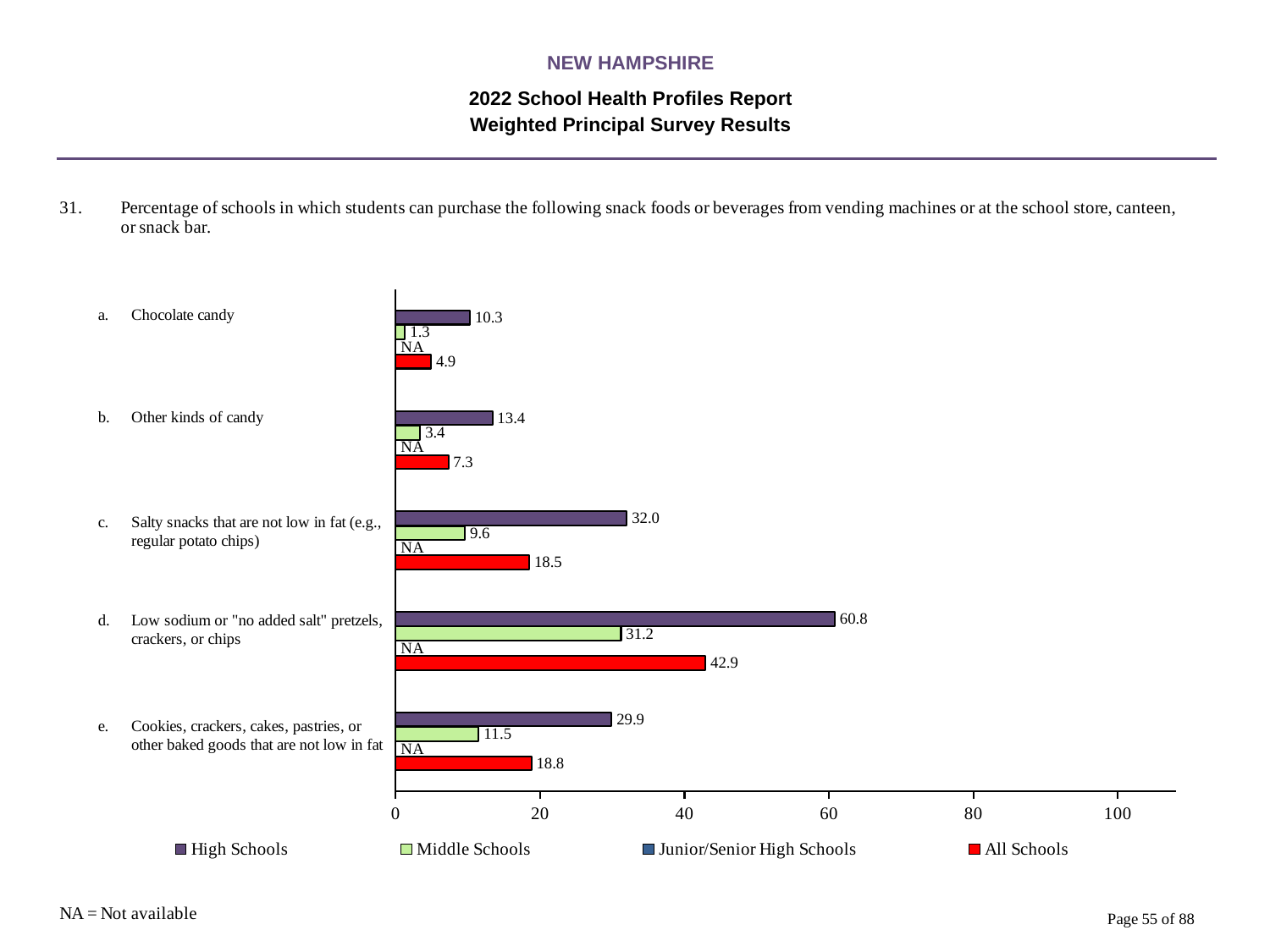
How many series does the legend list? 4 What kind of chart is shown on the slide? Bar chart What percentage of high schools allow students to purchase chocolate candy? 10.3 What is the Middle Schools value for cookies, crackers, cakes, pastries, or other baked goods that are not low in fat? 11.5 Is the High Schools value for low sodium or "no added salt" pretzels, crackers, or chips greater or less than 60? greater How many snack food categories are shown in the chart? 5 Which snack food category has the lowest Middle Schools value? Chocolate candy What value is shown for Junior/Senior High Schools in every category? NA Which is larger: the All Schools value for other kinds of candy or the All Schools value for chocolate candy? Other kinds of candy What is the All Schools value for low sodium or "no added salt" pretzels, crackers, or chips? 42.9 What is the difference between the High Schools and Middle Schools values for salty snacks that are not low in fat? 22.4 Which snack food category has the highest High Schools value? Low sodium or "no added salt" pretzels, crackers, or chips